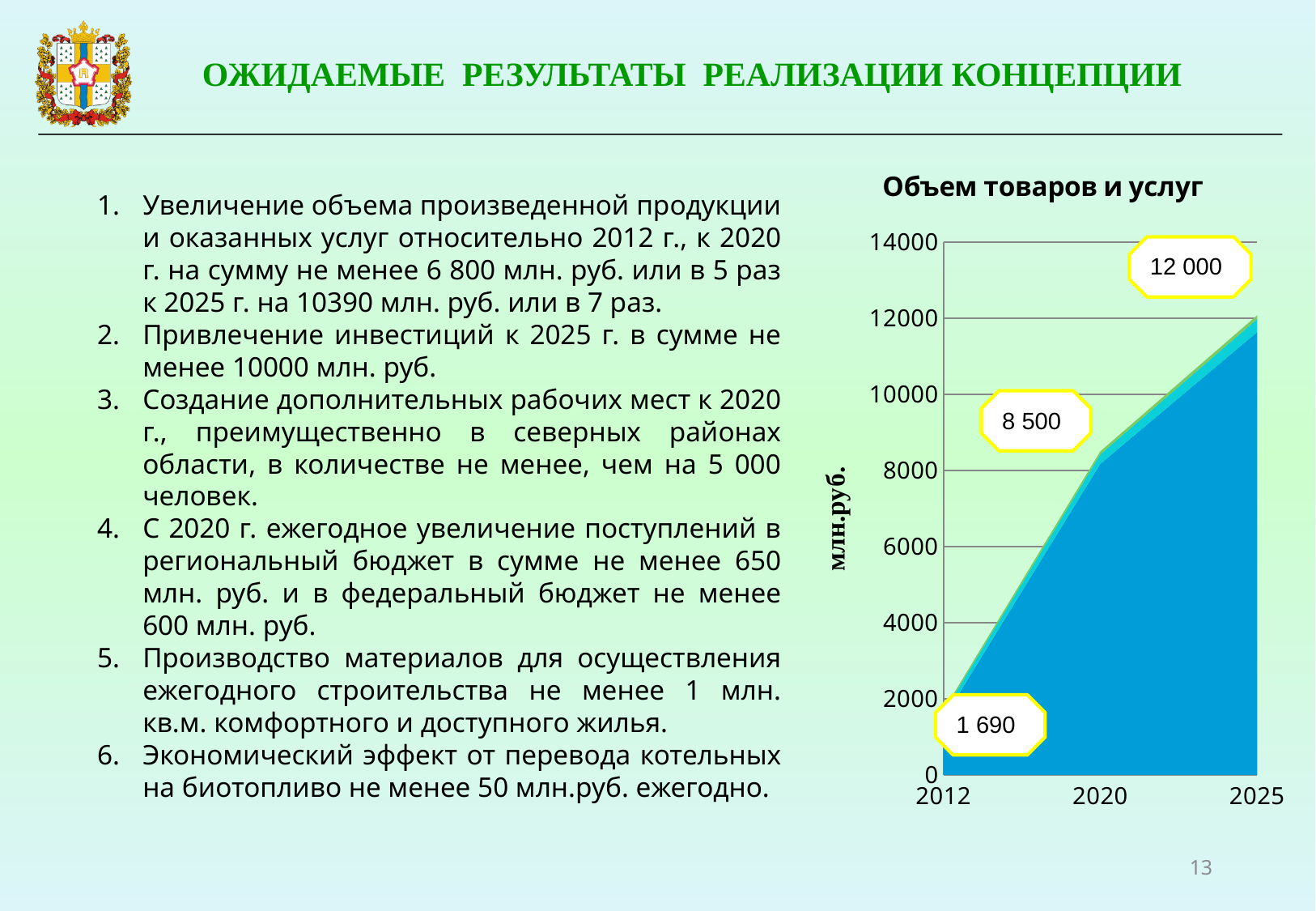
Which year has the highest value in the chart 'Объем товаров и услуг'? 2025 What is the value for 2025 in the chart 'Объем товаров и услуг'? 12 000 What is the value for 2012 in the chart 'Объем товаров и услуг'? 1 690 Is the value for 2020 in the chart 'Объем товаров и услуг' greater or less than 8000? greater What is the difference between the values for 2025 and 2020 in the chart 'Объем товаров и услуг'? 3 500 What is the difference between the values for 2020 and 2012 in the chart 'Объем товаров и услуг'? 6 810 Which year has the lowest value in the chart 'Объем товаров и услуг'? 2012 In the chart 'Объем товаров и услуг', which is larger: the value for 2020 or the value for 2012? 2020 What is the value for 2020 in the chart 'Объем товаров и услуг'? 8 500 How many years are plotted on the x axis of the chart 'Объем товаров и услуг'? 3 Do the values in the chart 'Объем товаров и услуг' rise or fall from 2012 to 2025? rise What unit is shown on the y axis of the chart 'Объем товаров и услуг'? млн.руб.